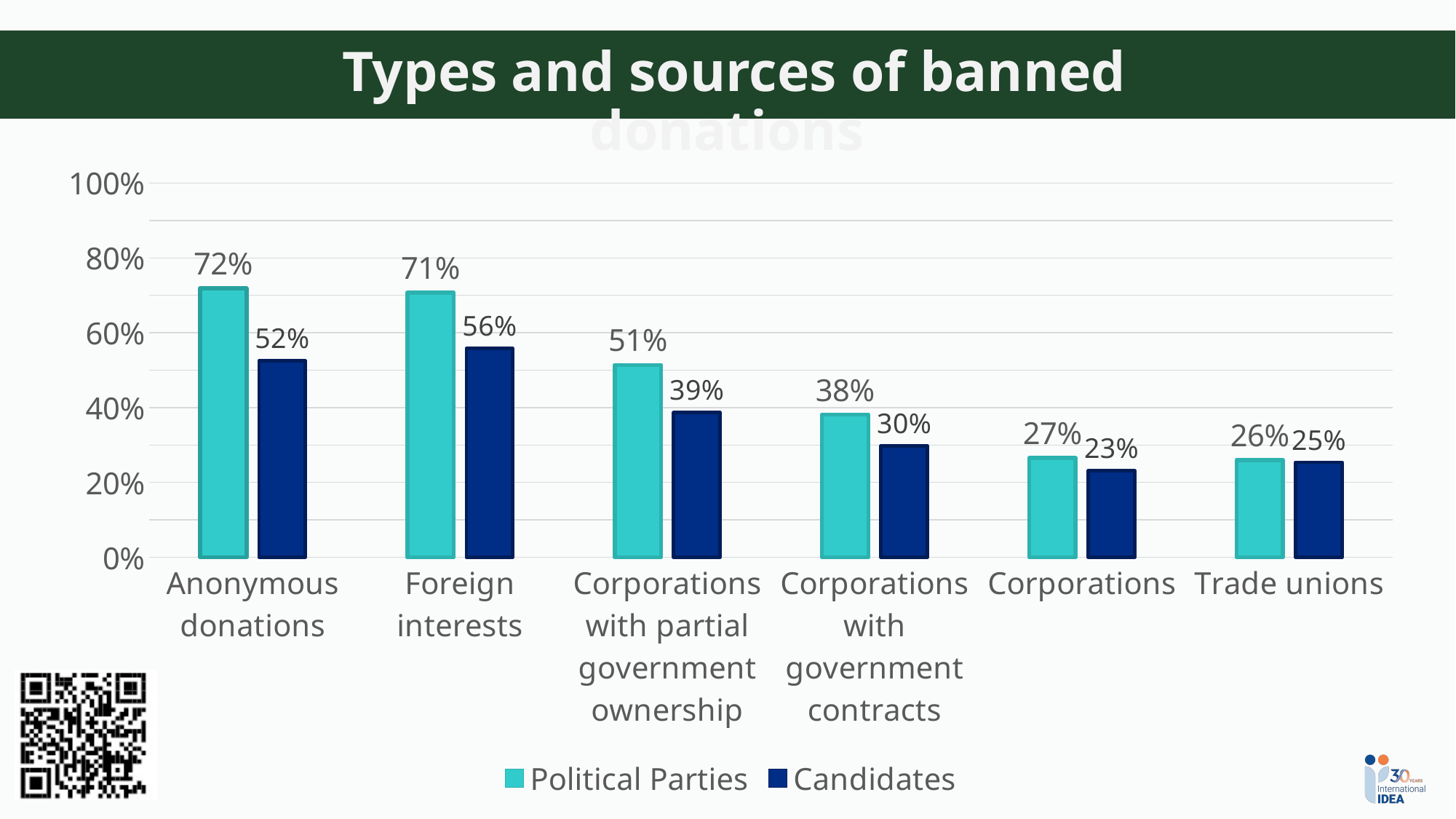
How many categories are shown on the x axis? 6 Which is larger for Corporations with partial government ownership: the Political Parties value or the Candidates value? Political Parties What is the Candidates value for Corporations with government contracts? 30% Is the Political Parties value for Foreign interests greater or less than 60%? greater What is the title of the chart? Types and sources of banned donations What is the difference between the Political Parties and Candidates values for Anonymous donations? 20% Which category has the lowest Candidates value? Corporations What is the Candidates value for Foreign interests? 56% What kind of chart is shown on the slide? Bar chart How many series does the legend list? 2 What is the Political Parties value for Anonymous donations? 72% Which category has the highest Political Parties value? Anonymous donations